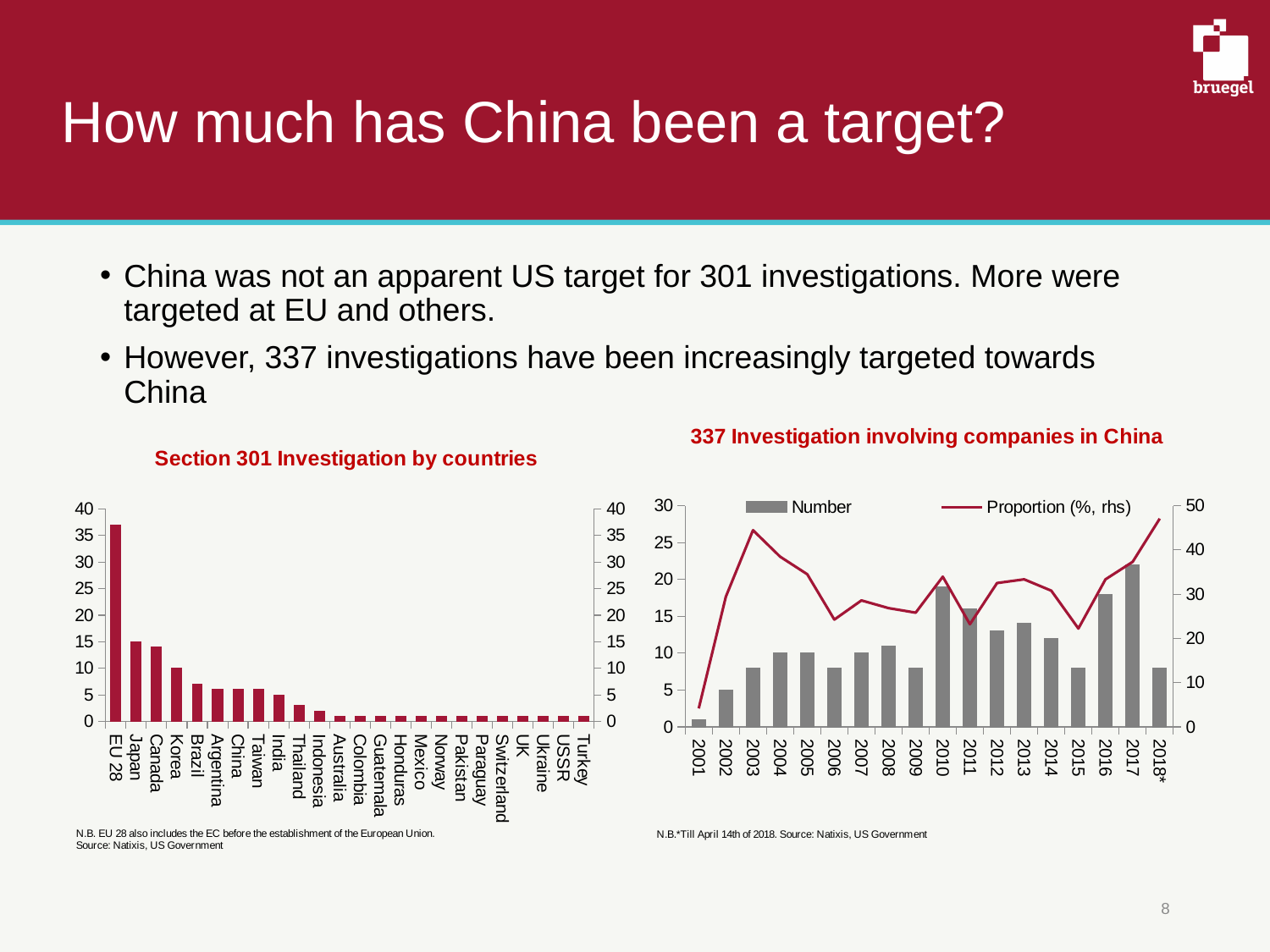
On the 'Section 301 Investigation by countries' chart, how many countries/categories are shown on the x axis? 24 On the '337 Investigation involving companies in China' chart, is the Number for 2017 greater or less than 20? greater On the '337 Investigation involving companies in China' chart, how many series does the legend list? 2 On the 'Section 301 Investigation by countries' chart, what kind of chart is used? Bar chart On the '337 Investigation involving companies in China' chart, what are the two legend entries? Number; Proportion (%, rhs) On the 'Section 301 Investigation by countries' chart, is the value for EU 28 greater or less than 35? greater On the 'Section 301 Investigation by countries' chart, is the value for Thailand greater or less than 5? less On the 'Section 301 Investigation by countries' chart, which has a larger value, Japan or Korea? Japan On the '337 Investigation involving companies in China' chart, how many years are shown on the x axis? 18 On the 'Section 301 Investigation by countries' chart, which category has the highest value? EU 28 On the '337 Investigation involving companies in China' chart, which year has the highest Number (tallest bar)? 2017 On the '337 Investigation involving companies in China' chart, which year has the highest Proportion (%, rhs)? 2018*